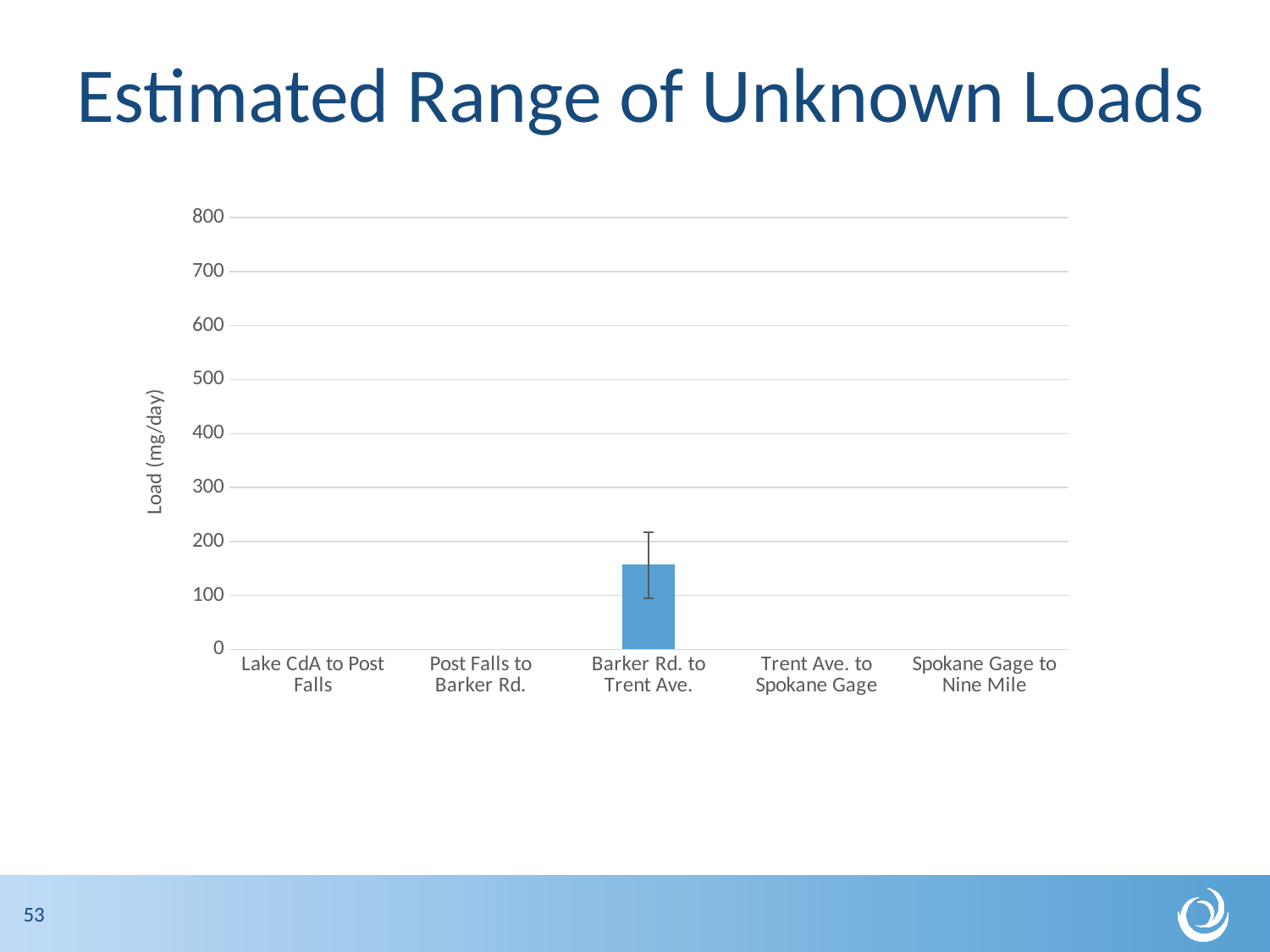
Which is larger, the value for Barker Rd. to Trent Ave. or the value for Post Falls to Barker Rd.? Barker Rd. to Trent Ave. What is the highest tick value shown on the y axis? 800 Which category is the only one with a visible bar in the chart? Barker Rd. to Trent Ave. What is the label of the y axis of the chart? Load (mg/day) What kind of chart is shown on the slide? bar chart How many categories are shown on the x axis of the chart? 5 Which is larger, the value for Barker Rd. to Trent Ave. or the value for Spokane Gage to Nine Mile? Barker Rd. to Trent Ave. Is the value for Barker Rd. to Trent Ave. greater or less than 100? greater Which category has the highest load in the chart? Barker Rd. to Trent Ave. Is the value for Barker Rd. to Trent Ave. greater or less than 300? less Is the value for Barker Rd. to Trent Ave. greater or less than 200? less